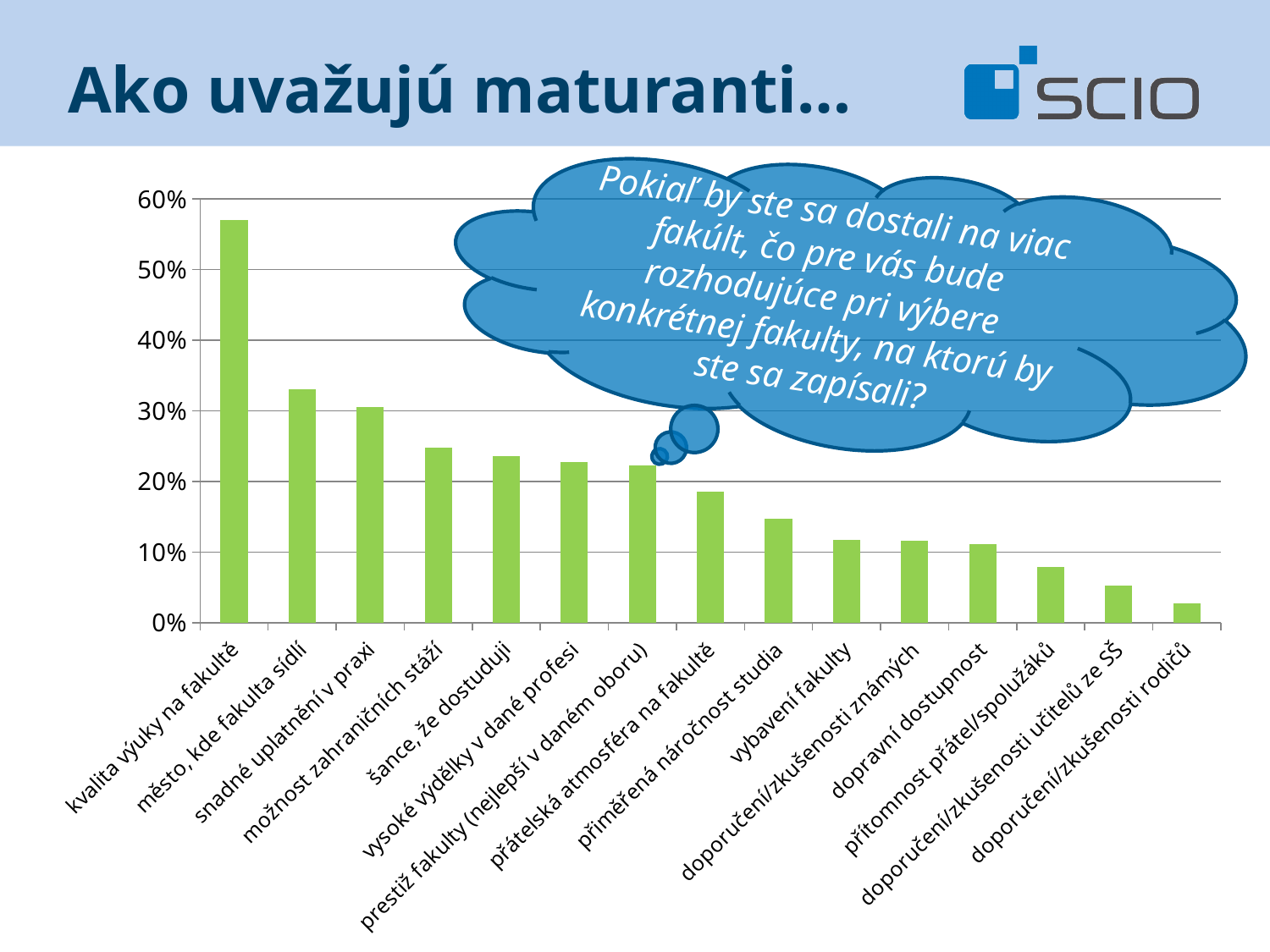
What kind of chart is shown on the slide? bar chart Is the value for 'město, kde fakulta sídlí' greater or less than 30%? greater Which is larger, the value for 'kvalita výuky na fakultě' or for 'město, kde fakulta sídlí'? kvalita výuky na fakultě Which category has the lowest value? doporučení/zkušenosti rodičů How many categories are plotted on the chart? 15 Is the value for 'kvalita výuky na fakultě' greater or less than 50%? greater Do the bar values rise or fall from left to right along the x axis? fall Is the value for 'přítomnost přátel/spolužáků' greater or less than 10%? less Which category has the highest value? kvalita výuky na fakultě Which is larger, the value for 'přátelská atmosféra na fakultě' or for 'přiměřená náročnost studia'? přátelská atmosféra na fakultě